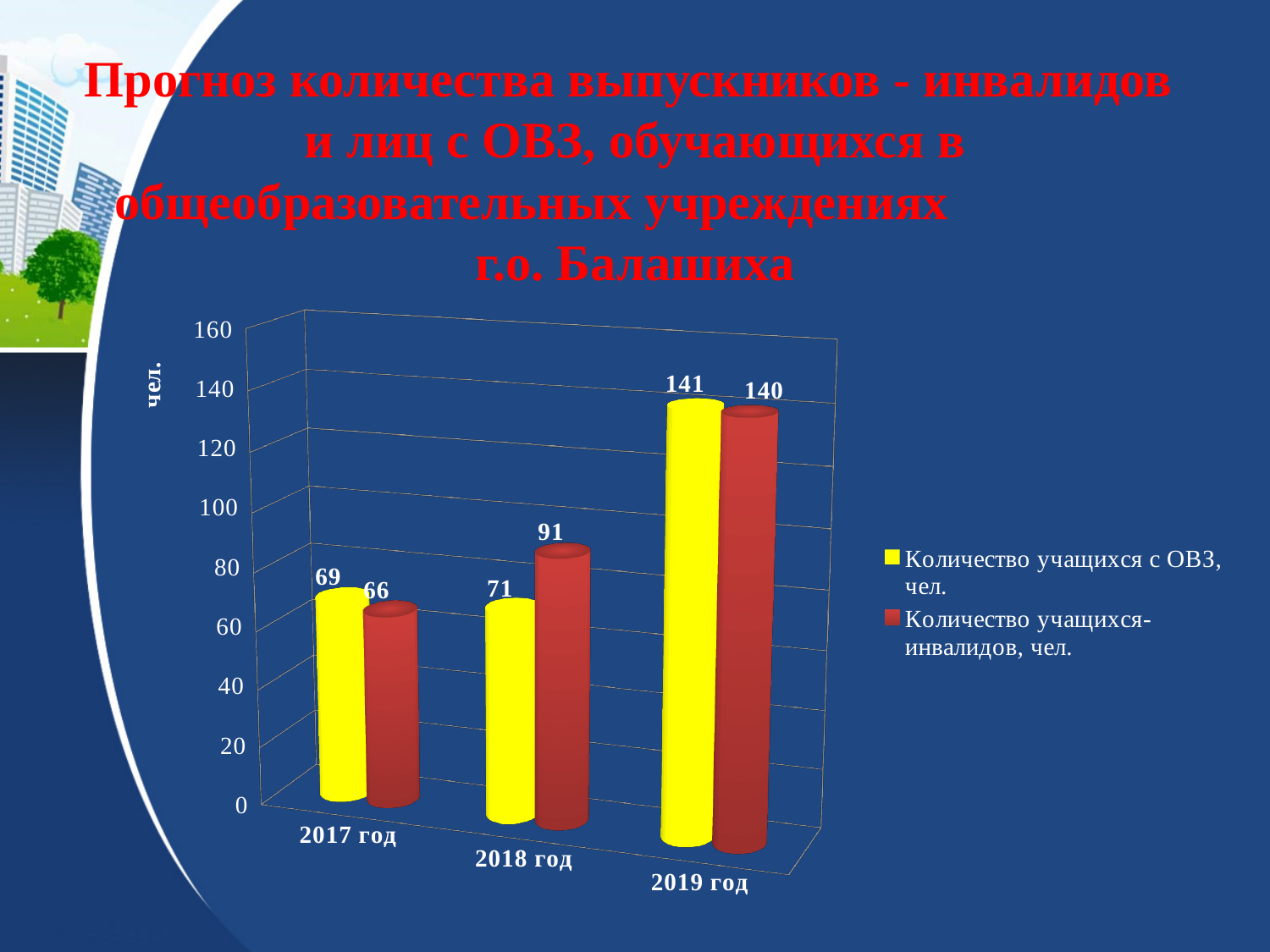
What kind of chart is shown on the slide? bar chart What is the value for 'Количество учащихся-инвалидов, чел.' in 2018 год? 91 What is the value for 'Количество учащихся-инвалидов, чел.' in 2019 год? 140 Do the values for 'Количество учащихся с ОВЗ, чел.' rise or fall from 2017 год to 2019 год? rise How many series does the legend list? 2 How many years are shown on the x axis? 3 Is the value for 'Количество учащихся с ОВЗ, чел.' in 2019 год greater or less than 120? greater In 2018 год, which series has the larger value: 'Количество учащихся с ОВЗ, чел.' or 'Количество учащихся-инвалидов, чел.'? Количество учащихся-инвалидов, чел. Which year has the lowest value for 'Количество учащихся-инвалидов, чел.'? 2017 год Which year has the highest value for 'Количество учащихся с ОВЗ, чел.'? 2019 год What is the difference between the 'Количество учащихся-инвалидов, чел.' values for 2018 год and 2017 год? 25 What is the value for 'Количество учащихся с ОВЗ, чел.' in 2017 год? 69